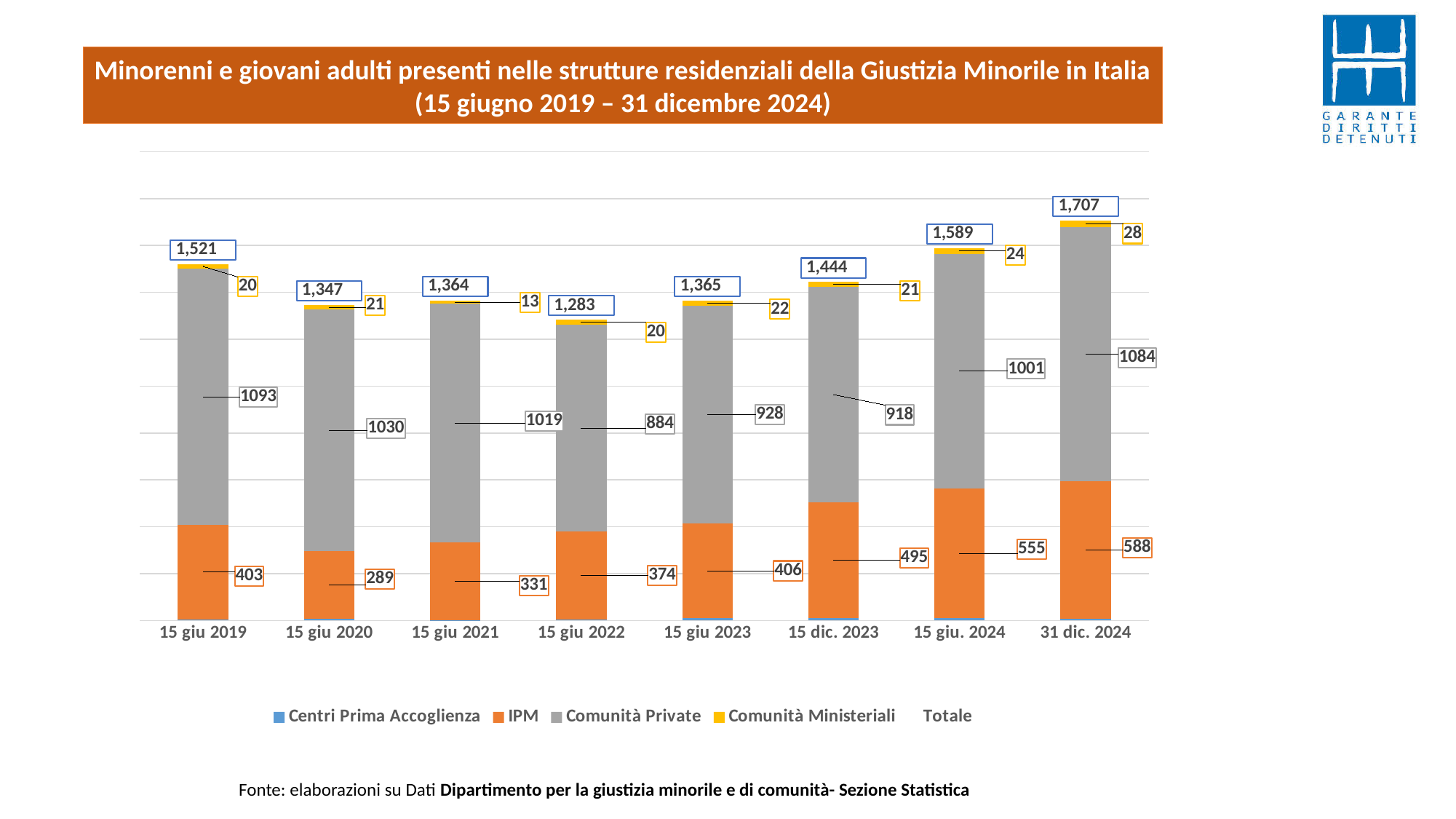
What is the difference between the IPM values for 31 dic. 2024 and 15 giu 2020? 299 What is the total (Totale) for 31 dic. 2024? 1,707 Which date has the lowest total? 15 giu 2022 Which is larger, the Comunità Private value for 15 giu 2019 or for 15 giu. 2024? 15 giu 2019 What is the Comunità Ministeriali value for 15 giu 2021? 13 What is the Comunità Private value for 15 giu 2022? 884 What type of chart is shown on the slide? Stacked bar chart How many dates (categories) are shown on the x axis? 8 Do the IPM values rise or fall from 15 giu 2020 to 31 dic. 2024? Rise How many series does the legend list? 5 What is the IPM value for 15 giu 2019? 403 Which date has the highest IPM value? 31 dic. 2024